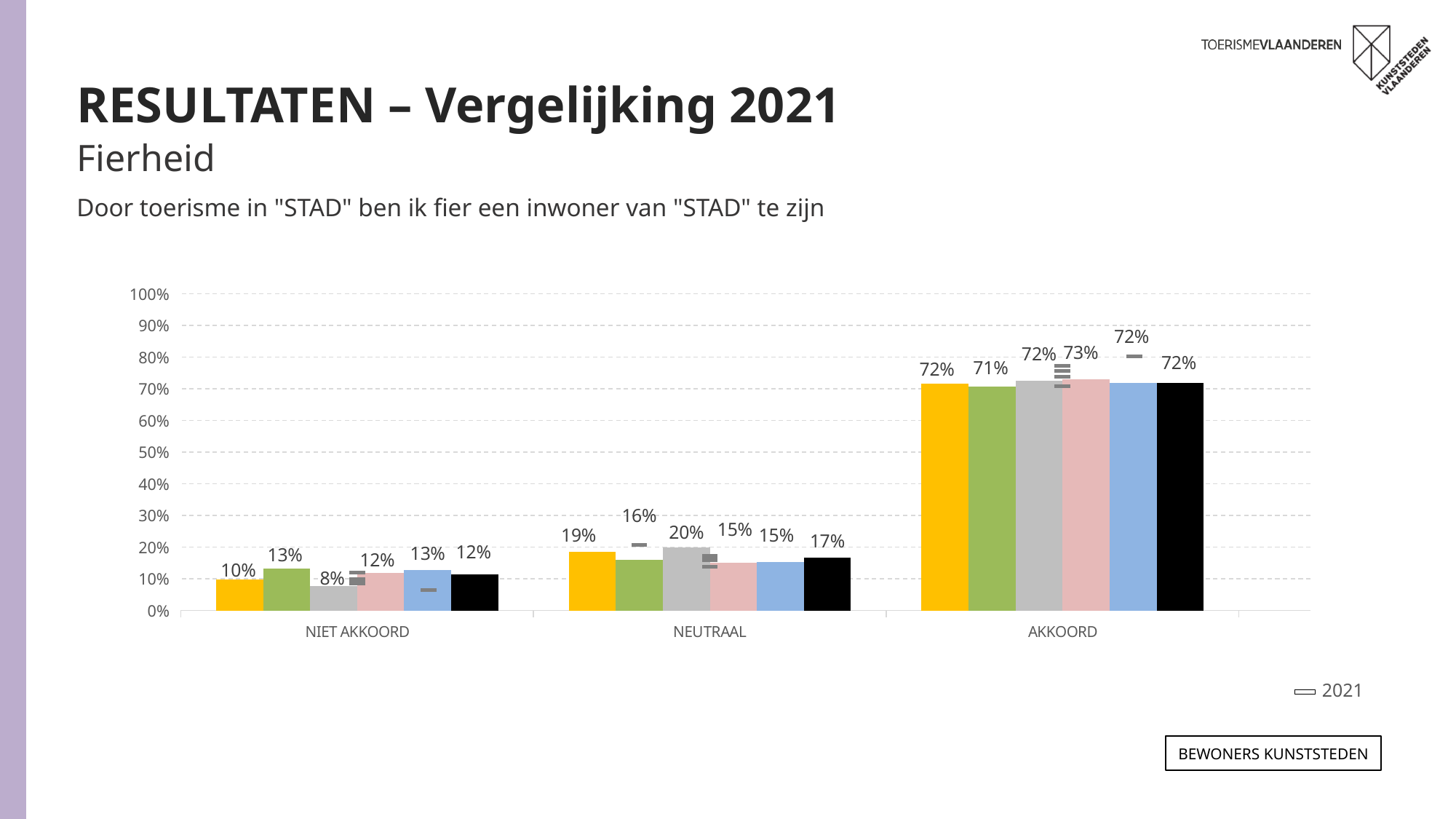
What is the value of the pink bar in the AKKOORD category? 73% What is the value of the black bar in the NEUTRAAL category? 17% Which is larger: the green bar in NIET AKKOORD or the grey bar in NIET AKKOORD? the green bar (13%) What is the value of the yellow bar in the NIET AKKOORD category? 10% How many categories are shown on the x axis of the chart? 3 What kind of chart is shown on the slide? bar chart What is the value of the grey bar in the NEUTRAAL category? 20% What entry does the chart legend list? 2021 Which bar has the highest value in the NEUTRAAL category? the grey bar (20%) Is the value of the yellow bar in the AKKOORD category greater or less than 50%? greater Which bar has the lowest value in the NIET AKKOORD category? the grey bar (8%) What is the difference between the yellow bar in NEUTRAAL (19%) and the yellow bar in NIET AKKOORD (10%)? 9 percentage points